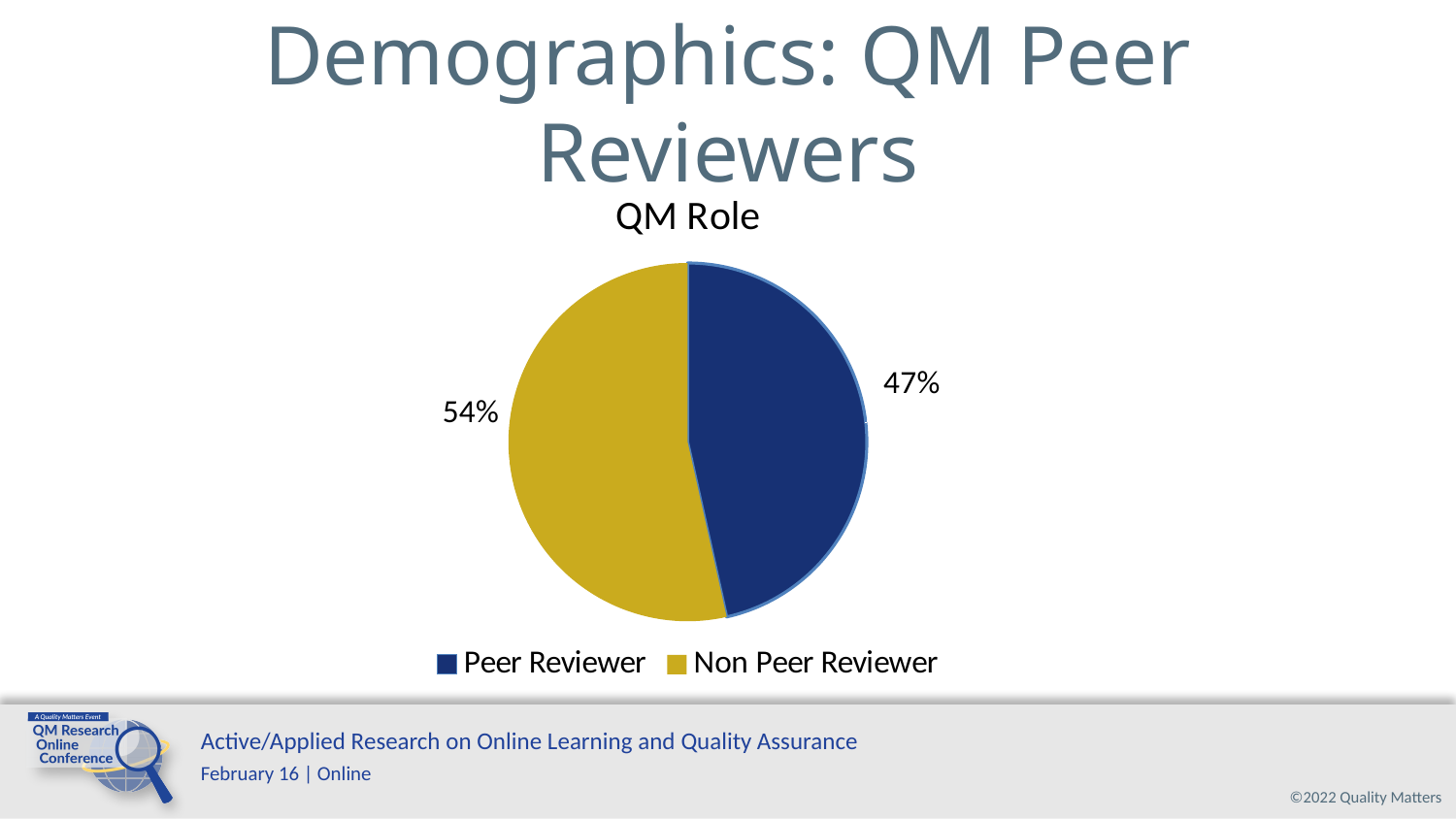
Which slice of the pie is the largest? Non Peer Reviewer What kind of chart is shown on the slide? pie chart How many entries does the legend list? 2 Which slice of the pie is the smallest? Peer Reviewer What share of the pie is Peer Reviewer? 47% What is the value shown for the Peer Reviewer slice? 47% Which is larger, the Peer Reviewer slice or the Non Peer Reviewer slice? Non Peer Reviewer What is the value shown for the Non Peer Reviewer slice? 54% What share of the pie is Non Peer Reviewer? 54% How many slices does the pie chart have? 2 What is the title of the chart? QM Role What is the difference in percentage points between the Non Peer Reviewer and Peer Reviewer slices? 7 percentage points